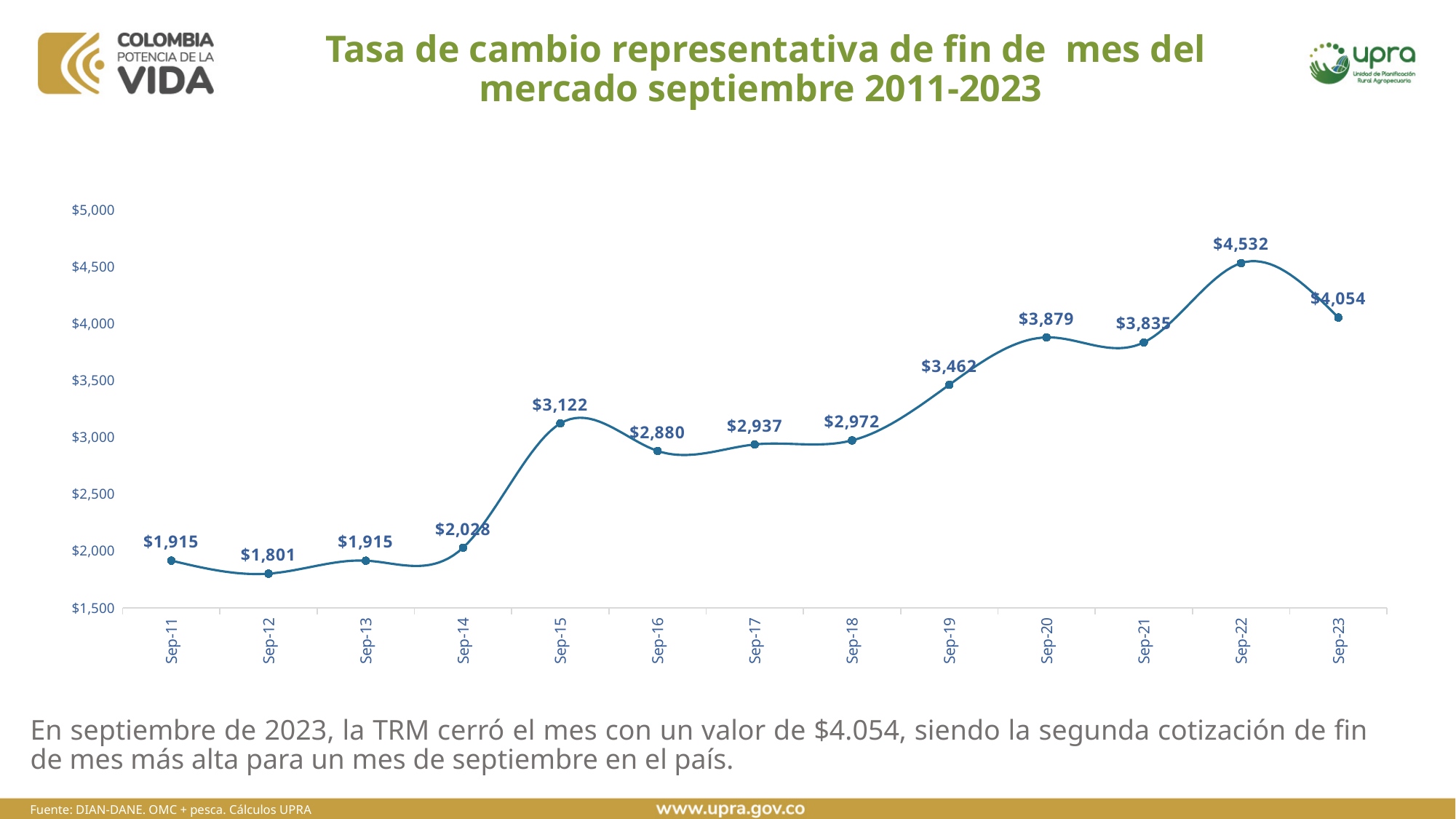
What is the value for Sep-12? $1,801 Which point has the lowest value? Sep-12 How many data points are plotted on the chart? 13 What kind of chart is shown on the slide? line chart Which is larger, the value for Sep-20 or the value for Sep-21? Sep-20 What is the value for Sep-15? $3,122 What is the difference between the values for Sep-14 and Sep-15? $1,094 What is the value for Sep-20? $3,879 Do the values generally rise or fall from Sep-11 to Sep-23? rise What is the difference between the values for Sep-22 and Sep-23? $478 Which point has the highest value? Sep-22 Is the value for Sep-19 greater or less than $3,000? greater